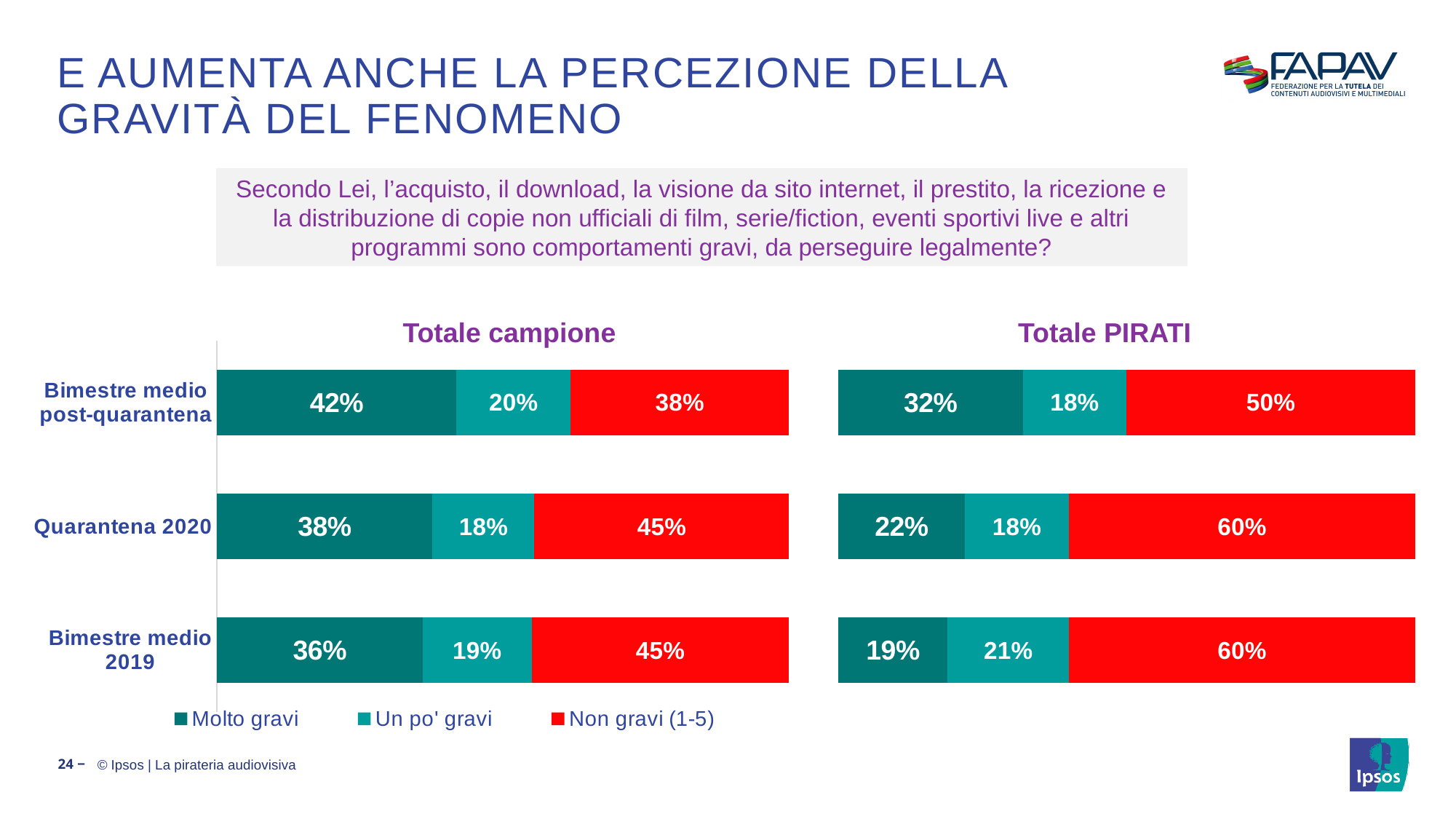
In the 'Totale campione' chart, which category has the highest 'Molto gravi' value? Bimestre medio post-quarantena In the 'Totale campione' chart, what is the difference between the 'Non gravi (1-5)' values for 'Quarantena 2020' and 'Bimestre medio post-quarantena'? 7% Which is larger: the 'Molto gravi' value for 'Bimestre medio post-quarantena' in the 'Totale campione' chart or in the 'Totale PIRATI' chart? Totale campione In the 'Totale campione' chart, what is the 'Molto gravi' value for 'Bimestre medio post-quarantena'? 42% In the 'Totale PIRATI' chart, what is the difference between the 'Molto gravi' values for 'Bimestre medio post-quarantena' and 'Quarantena 2020'? 10% In the 'Totale PIRATI' chart, what is the 'Un po' gravi' value for 'Bimestre medio 2019'? 21% In the 'Totale PIRATI' chart, what is the total of the stacked bar for 'Bimestre medio post-quarantena'? 100% How many series does the legend list? 3 In the 'Totale PIRATI' chart, which category has the lowest 'Molto gravi' value? Bimestre medio 2019 What kind of chart is the 'Totale campione' chart? Stacked bar chart How many categories are shown in the 'Totale PIRATI' chart? 3 In the 'Totale PIRATI' chart, what is the 'Non gravi (1-5)' value for 'Quarantena 2020'? 60%